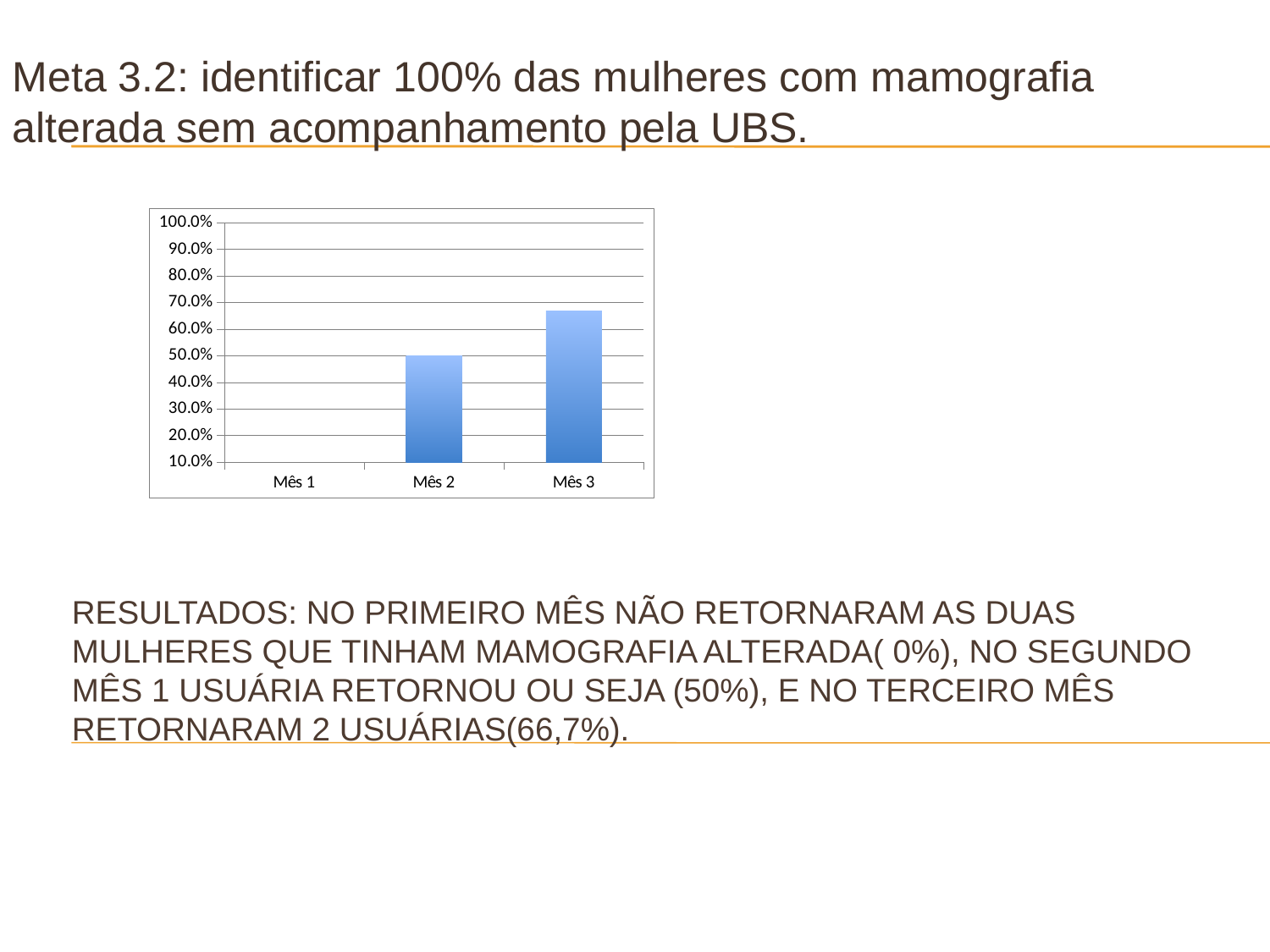
Which is larger, the value for Mês 2 or the value for Mês 3? Mês 3 Is the value for Mês 2 greater or less than 40%? greater Which month has the highest bar in the chart? Mês 3 Do the values rise or fall from Mês 1 to Mês 3? rise Is the value for Mês 3 greater or less than 60%? greater Is the value for Mês 3 greater or less than 70%? less What is the value for Mês 2 in the chart? 50.0% What kind of chart is shown on the slide? bar chart Which month has the lowest value in the chart? Mês 1 How many categories are shown on the x axis of the chart? 3 What is the lowest tick label shown on the y axis of the chart? 10.0% What is the highest value shown on the y axis of the chart? 100.0%